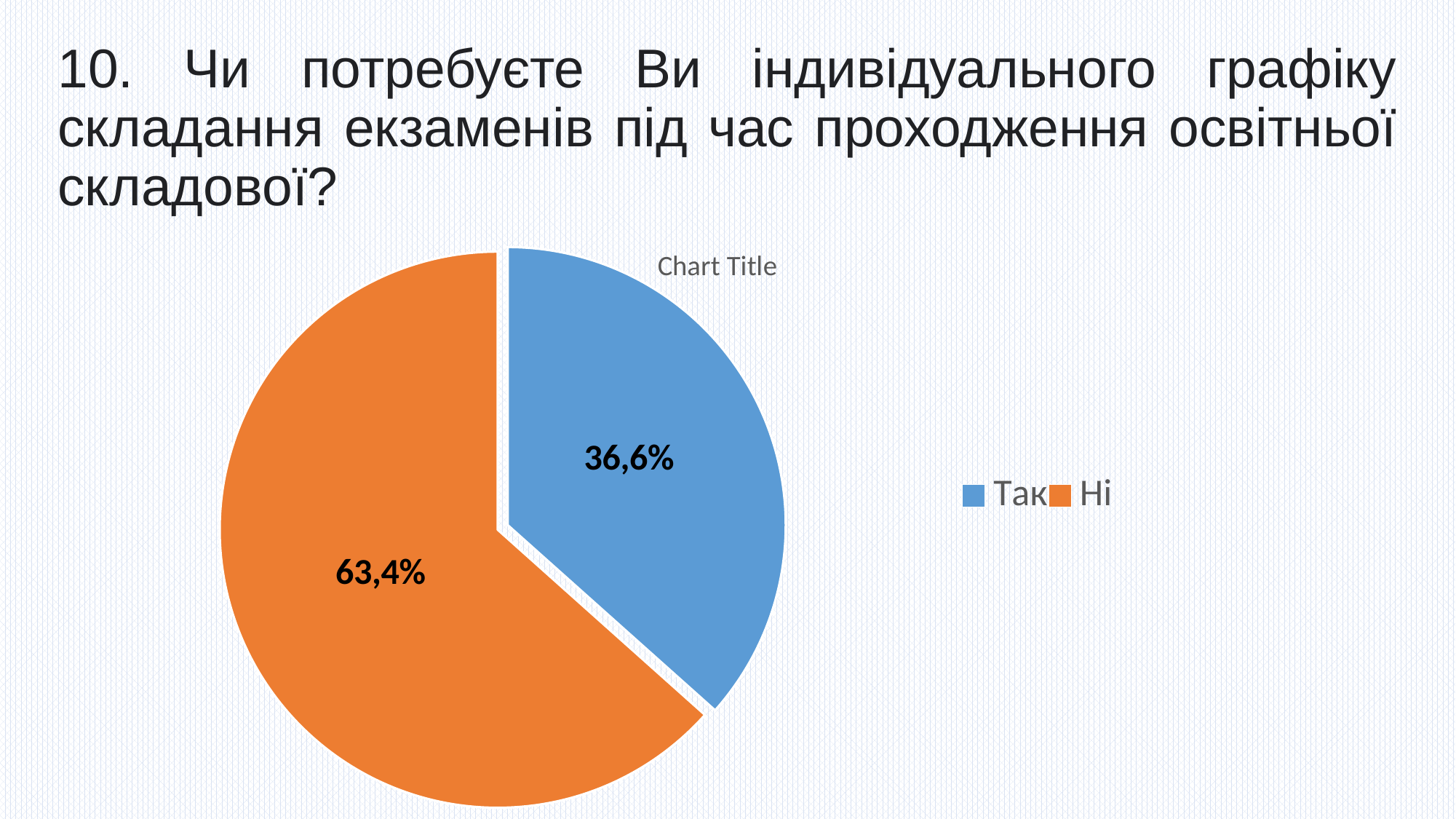
What percentage of respondents answered "Так"? 36,6% Which answer has the smallest share of the pie? Так How many entries does the legend list? 2 What is the title shown on the chart? Chart Title What kind of chart is shown on the slide? Pie chart What is the share of the pie taken by the "Ні" slice? 63,4% Which answer has the largest share of the pie? Ні What is the difference in percentage points between the "Ні" and "Так" slices? 26,8 Which slice is larger, "Так" or "Ні"? Ні How many slices does the pie chart have? 2 What colour is the "Так" slice? Blue What percentage of respondents answered "Ні"? 63,4%